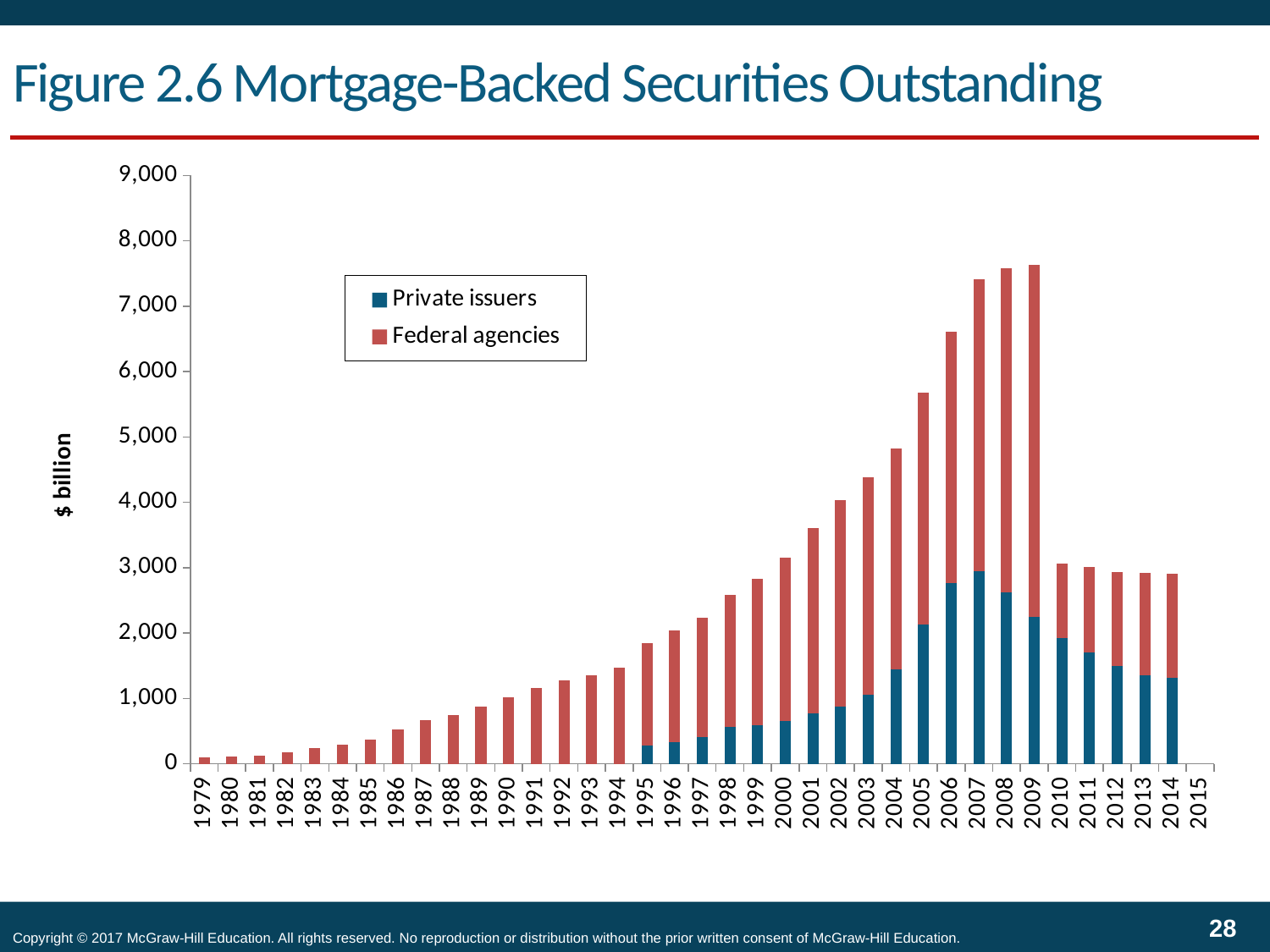
Do the total values rise or fall from 1979 to 2007? rise What kind of chart is shown on the slide? Stacked bar chart Is the Private issuers value for 2014 greater or less than 1,000? greater Is the Private issuers value for 2007 greater or less than 2,000? greater What is the label on the vertical axis? $ billion What are the two series named in the legend? Private issuers and Federal agencies Is the total value for 2001 greater or less than 3,000? greater Which year has the larger total bar, 2000 or 2007? 2007 How many series does the legend list? 2